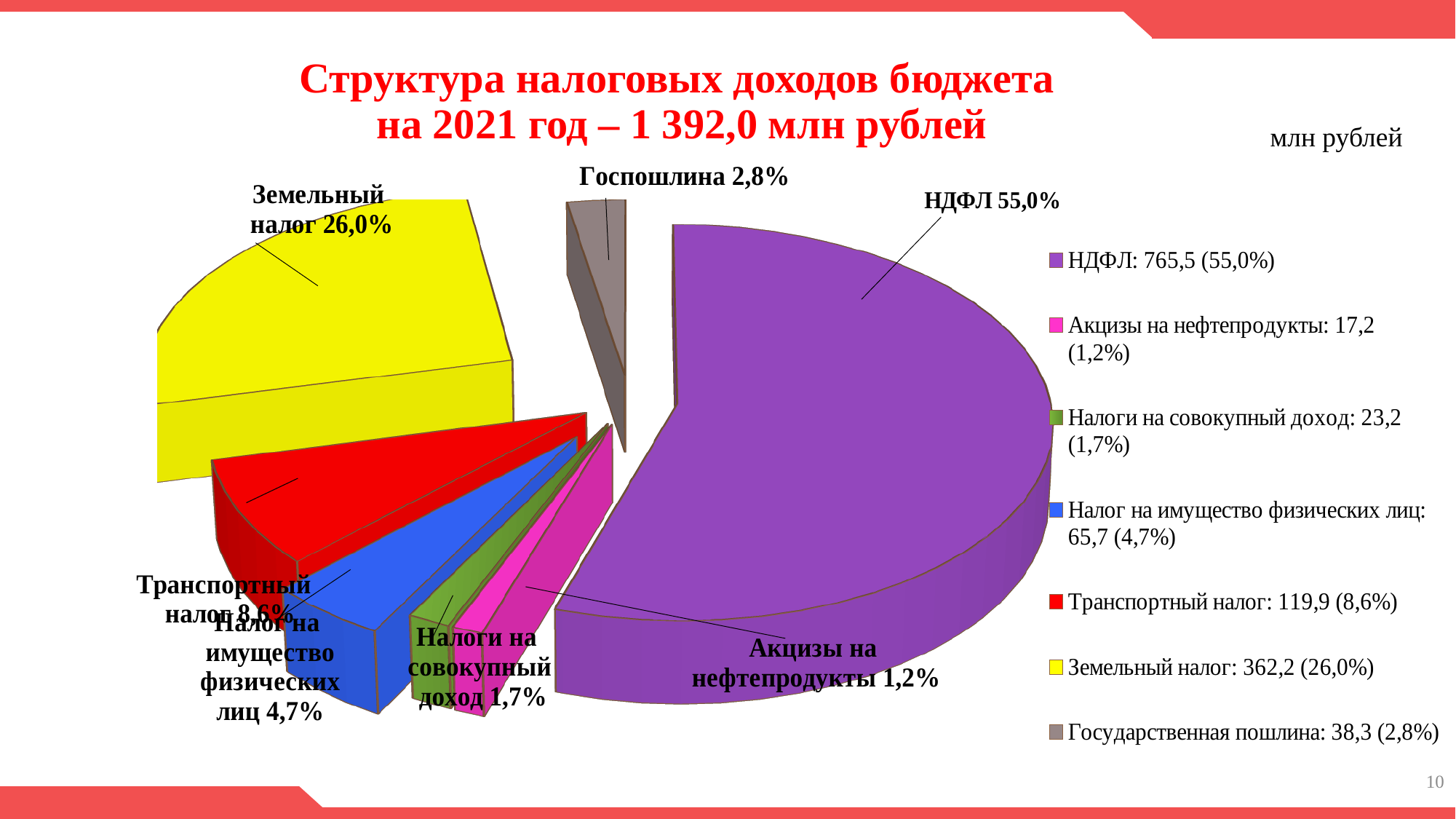
What colour is the slice for Земельный налог? yellow What total amount in млн рублей is stated in the chart title? 1 392,0 What is the value for Земельный налог in млн рублей? 362,2 Which category has the largest slice of the pie? НДФЛ What is the difference between the values for НДФЛ and Земельный налог, in млн рублей? 403,3 How many categories does the pie chart show? 7 What share of the pie does НДФЛ take? 55,0% Which category has the smallest slice of the pie? Акцизы на нефтепродукты Which is larger: Налог на имущество физических лиц or Налоги на совокупный доход? Налог на имущество физических лиц What share of the pie does Государственная пошлина take? 2,8% What is the value for Транспортный налог in млн рублей? 119,9 What kind of chart is shown on the slide? pie chart